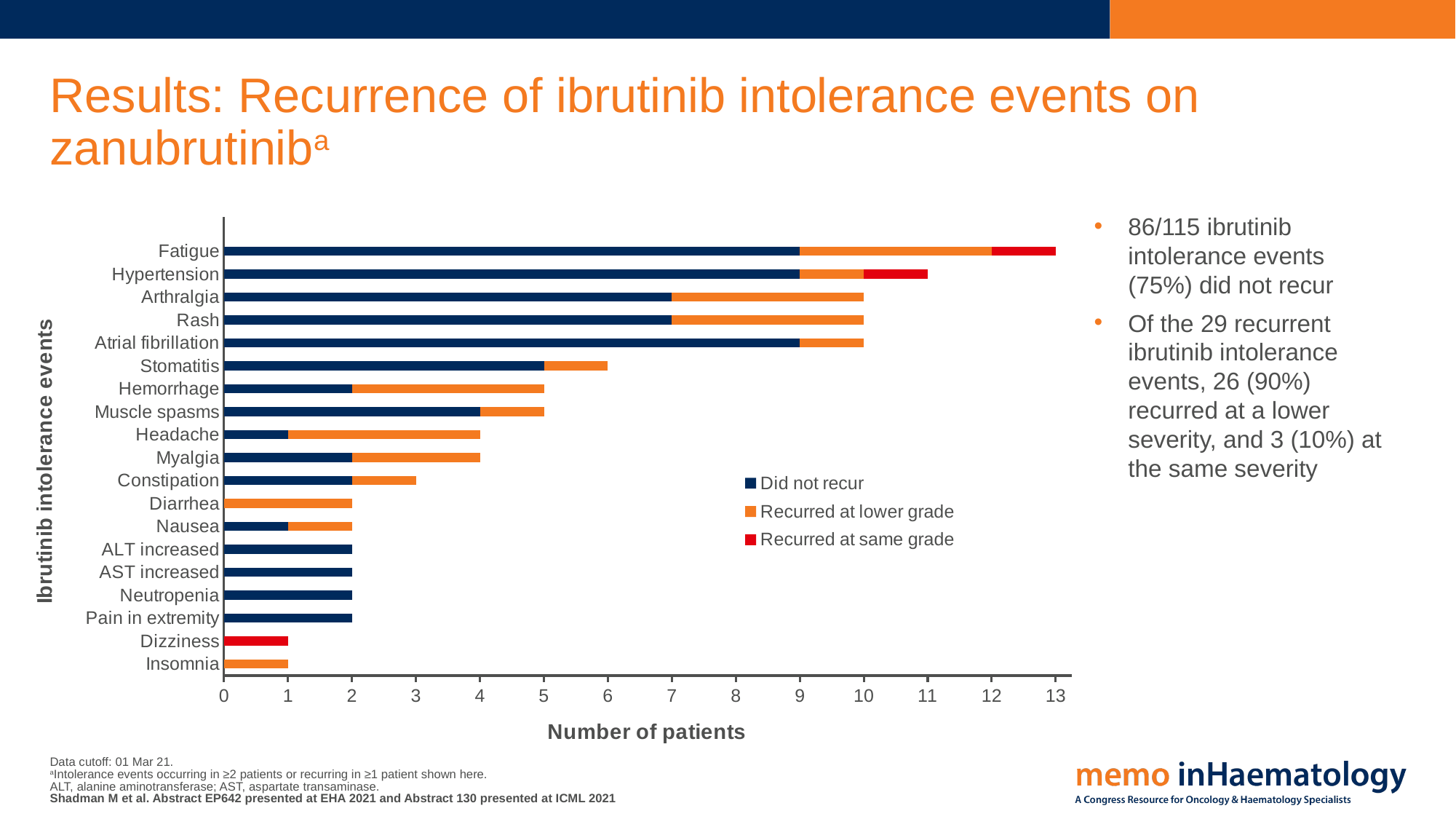
How many ibrutinib intolerance events are listed on the y axis of the chart? 19 Which has a larger total number of patients, Stomatitis or Hemorrhage? Stomatitis What is the difference between the total number of patients for Fatigue and for Hypertension? 2 Which series is shown in red in the legend? Recurred at same grade What is the total number of patients for Fatigue? 13 What is the total number of patients for Hypertension? 11 How many series does the legend list? 3 What kind of chart is shown on the slide? Stacked horizontal bar chart How many patients with Fatigue are in the 'Did not recur' category? 9 What is the label of the x axis of the chart? Number of patients Which ibrutinib intolerance event has the highest total number of patients? Fatigue Is the total number of patients for Arthralgia greater or less than 5? greater